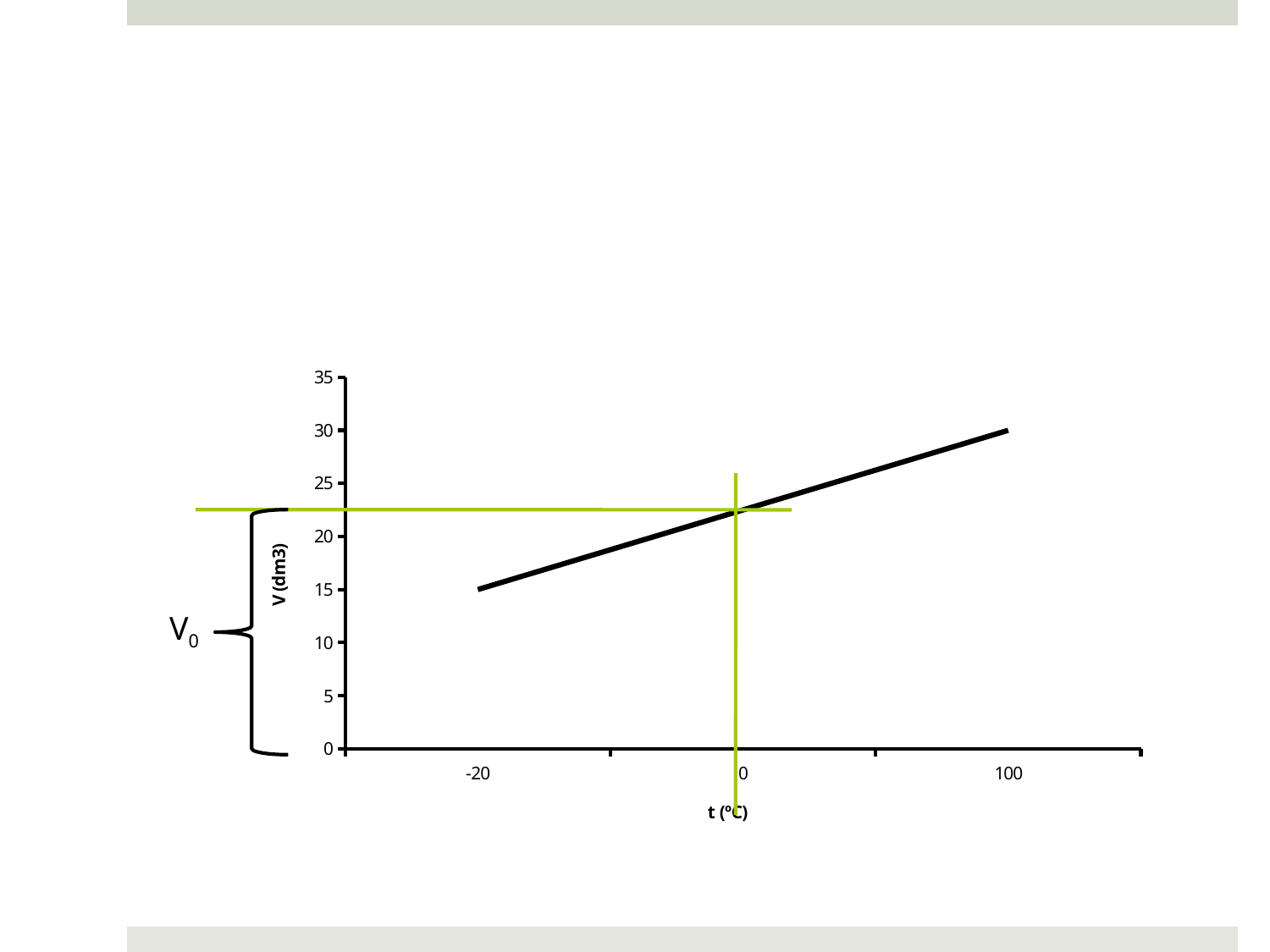
At which labelled temperature is V lowest? -20 Does the volume V rise or fall as the temperature t increases along the x axis? rise At which labelled temperature is V highest? 100 What kind of chart is shown on the slide? line chart What is the value of V at t = 100? 30 What is the value of V at t = -20? 15 What is the difference between V at t = 100 and V at t = -20? 15 What is the label of the vertical axis? V (dm3) What is the label of the horizontal axis? t (°C) Which is larger, V at t = 100 or V at t = -20? V at t = 100 How many temperature values are labelled on the x axis? 3 Is the value of V at t = 0 greater or less than 20? greater